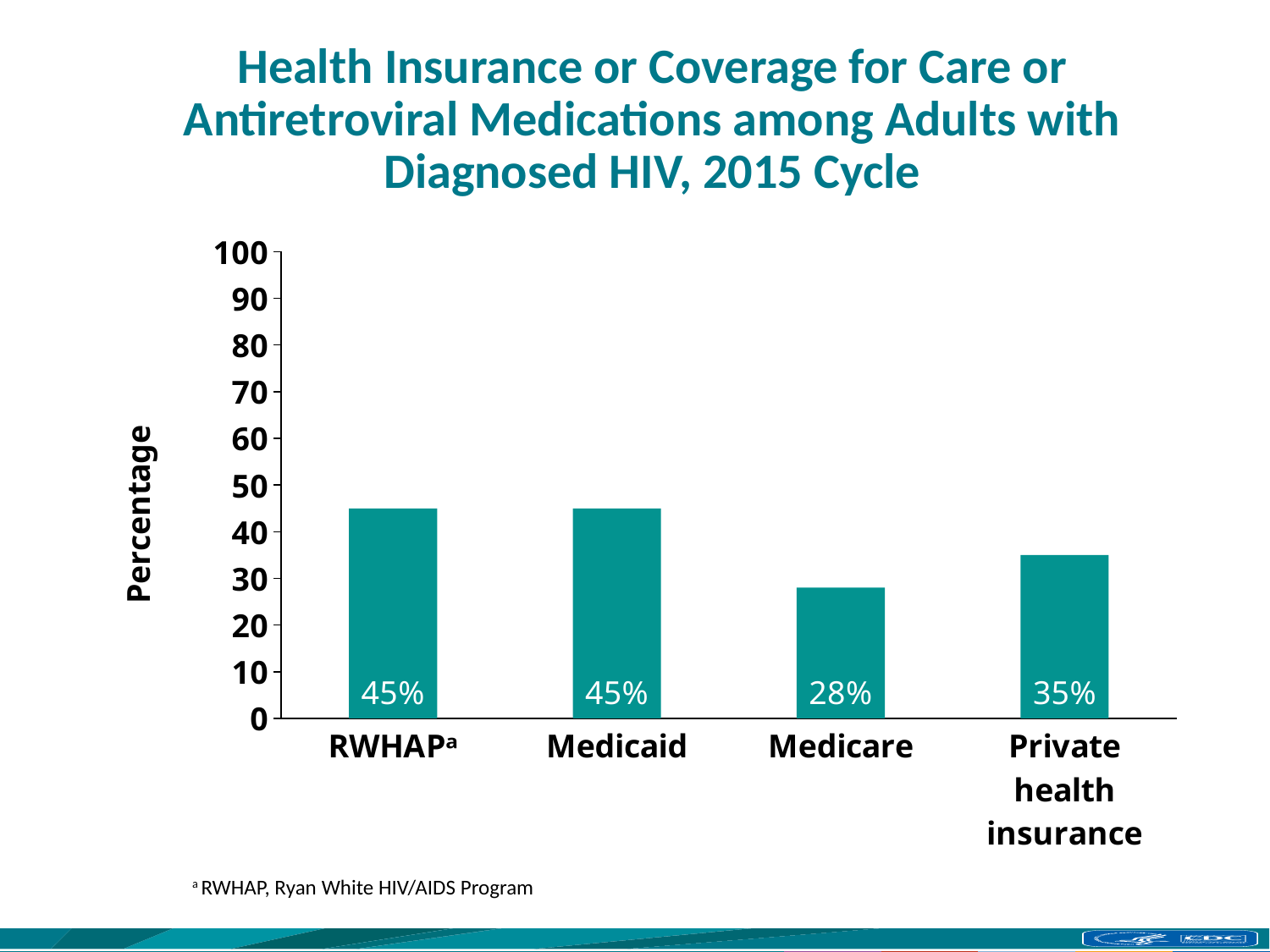
What is the difference in percentage points between Medicaid and Private health insurance? 10 What percentage is shown for RWHAP? 45% What kind of chart is shown on the slide? Bar chart What percentage is shown for Private health insurance? 35% What is the difference in percentage points between Private health insurance and Medicare? 7 What is the label of the y axis? Percentage What percentage is shown for Medicaid? 45% Which is larger, the value for Medicare or the value for Private health insurance? Private health insurance Which category has the lowest percentage? Medicare Is the value for Medicare greater or less than 30? less How many categories are shown on the x axis? 4 What percentage is shown for Medicare? 28%